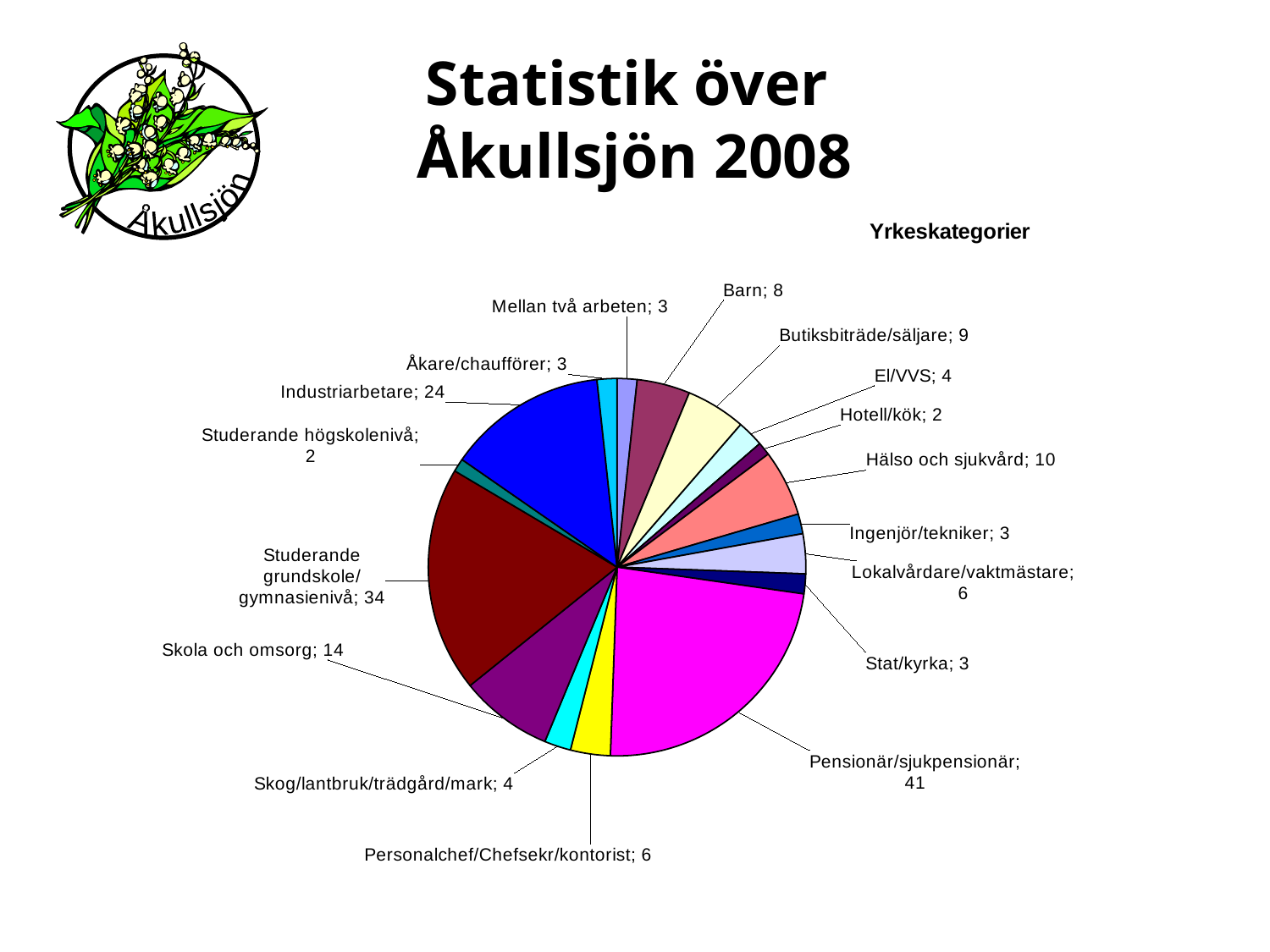
Which category has the largest slice in the pie chart? Pensionär/sjukpensionär What is the value for Hälso och sjukvård in the pie chart? 10 What is the value for Lokalvårdare/vaktmästare in the pie chart? 6 What is the title of the chart? Yrkeskategorier What is the difference between the values for Pensionär/sjukpensionär and Studerande grundskole/gymnasienivå? 7 What is the difference between the values for Industriarbetare and Skola och omsorg? 10 What is the value for Pensionär/sjukpensionär in the pie chart? 41 What is the value for Skola och omsorg in the pie chart? 14 Which is larger, Butiksbiträde/säljare or Barn? Butiksbiträde/säljare What kind of chart is shown on the slide? Pie chart How many categories are shown in the pie chart? 17 What is the value for Industriarbetare in the pie chart? 24